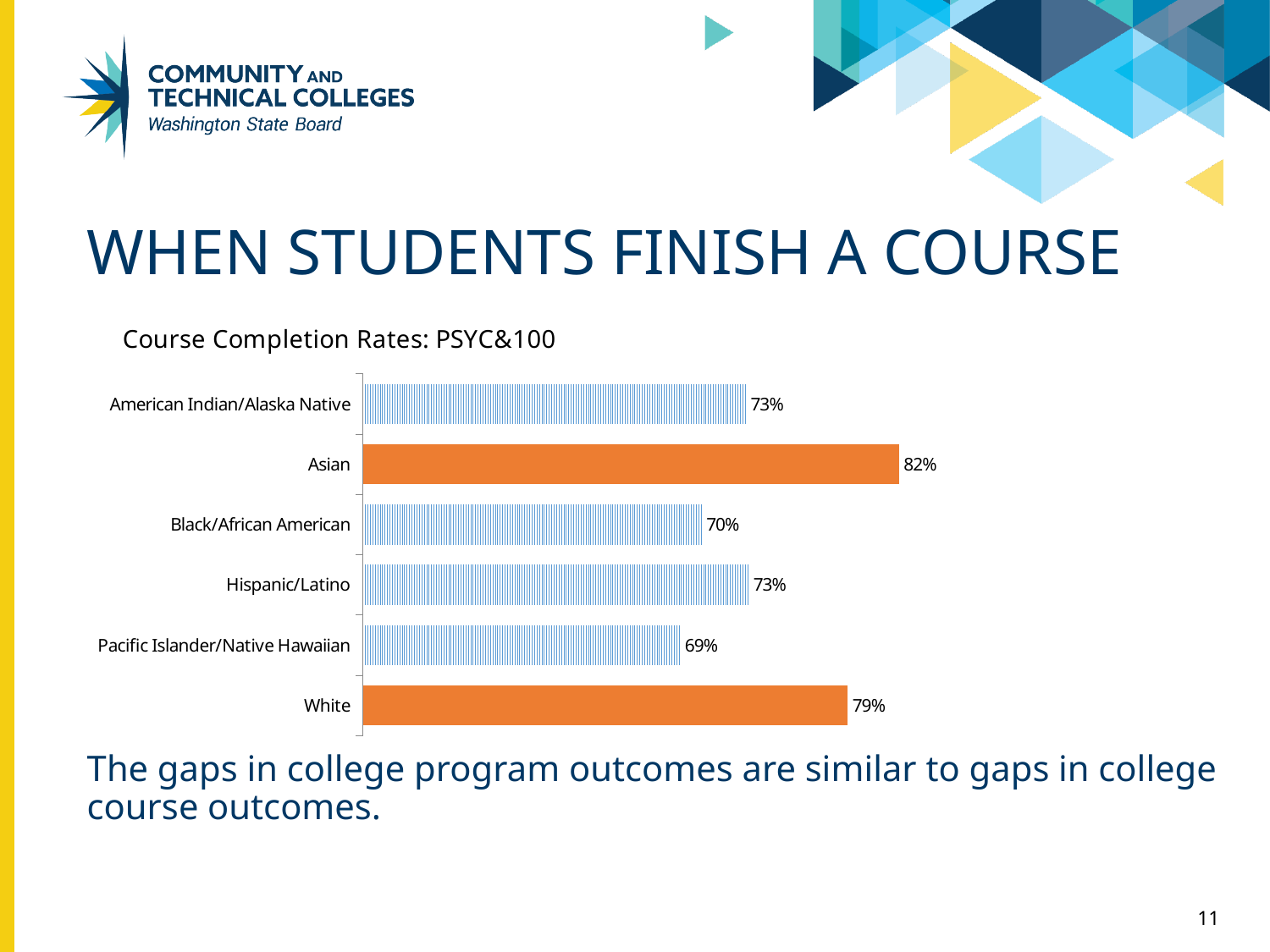
What is the course completion rate for White students? 79% What kind of chart is shown on the slide? Bar chart What is the course completion rate for Black/African American students? 70% How many categories are shown in the chart? 6 Which category has the highest course completion rate? Asian What is the difference between the completion rates for Asian and Pacific Islander/Native Hawaiian students? 13% What is the difference between the completion rates for White and Black/African American students? 9% What is the course completion rate for Asian students? 82% Which has a higher completion rate, White or Hispanic/Latino? White What is the title of the chart? Course Completion Rates: PSYC&100 What is the course completion rate for Pacific Islander/Native Hawaiian students? 69% Which category has the lowest course completion rate? Pacific Islander/Native Hawaiian